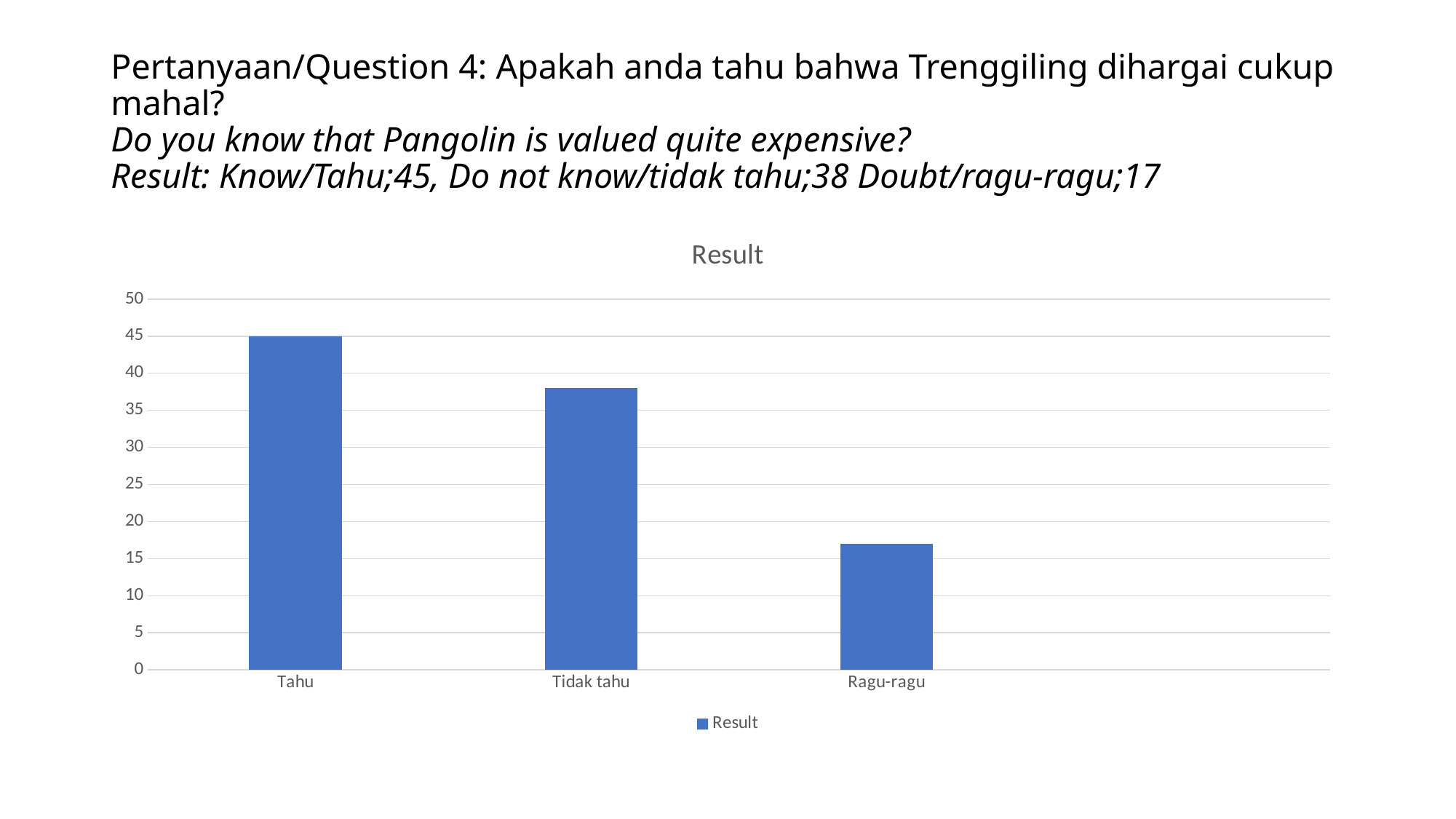
What is the difference between the values for Tidak tahu and Ragu-ragu? 21 Which is larger, the value for Tidak tahu or the value for Ragu-ragu? Tidak tahu What is the value for Ragu-ragu in the Result chart? 17 Is the value for Ragu-ragu greater or less than 20? less How many categories are shown on the x axis of the chart? 3 What is the value for Tidak tahu in the Result chart? 38 What kind of chart is shown on the slide? bar chart What is the value for Tahu in the Result chart? 45 Which category has the lowest value in the chart? Ragu-ragu What is the title of the chart? Result What is the difference between the values for Tahu and Tidak tahu? 7 Which category has the highest value in the chart? Tahu